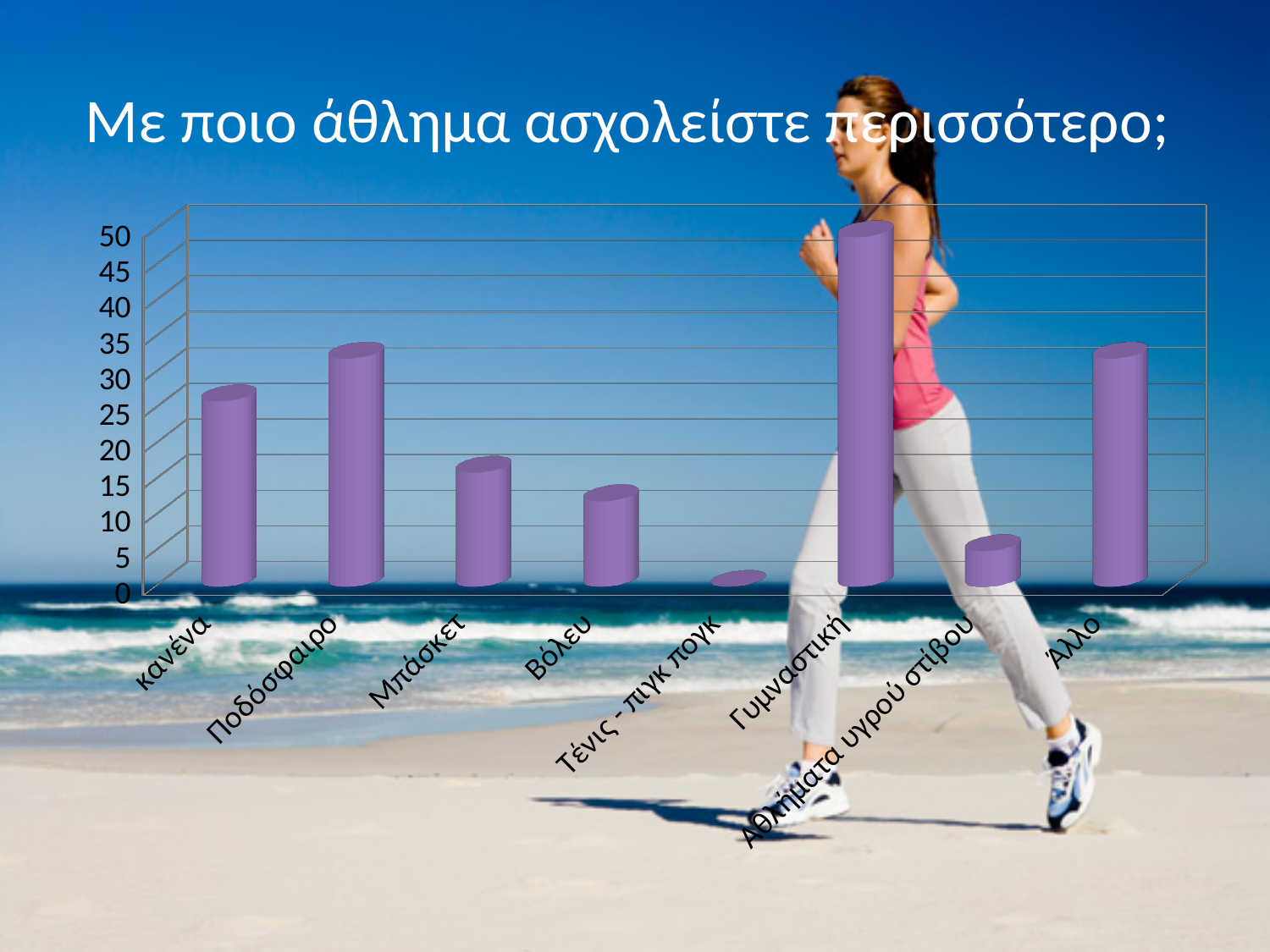
What is the title of the chart on the slide? Με ποιο άθλημα ασχολείστε περισσότερο; Is the value for Βόλεϋ greater or less than 15? less Which has the larger value, Ποδόσφαιρο or κανένα? Ποδόσφαιρο How many categories are shown on the x axis of the chart? 8 Which category has the lowest bar in the chart? Τένις - πιγκ πογκ Is the value for Αθλήματα υγρού στίβου greater or less than 10? less What kind of chart is shown on the slide? bar chart Is the value for κανένα greater or less than 20? greater Which category has the highest bar in the chart? Γυμναστική What colour are the bars in the chart? purple